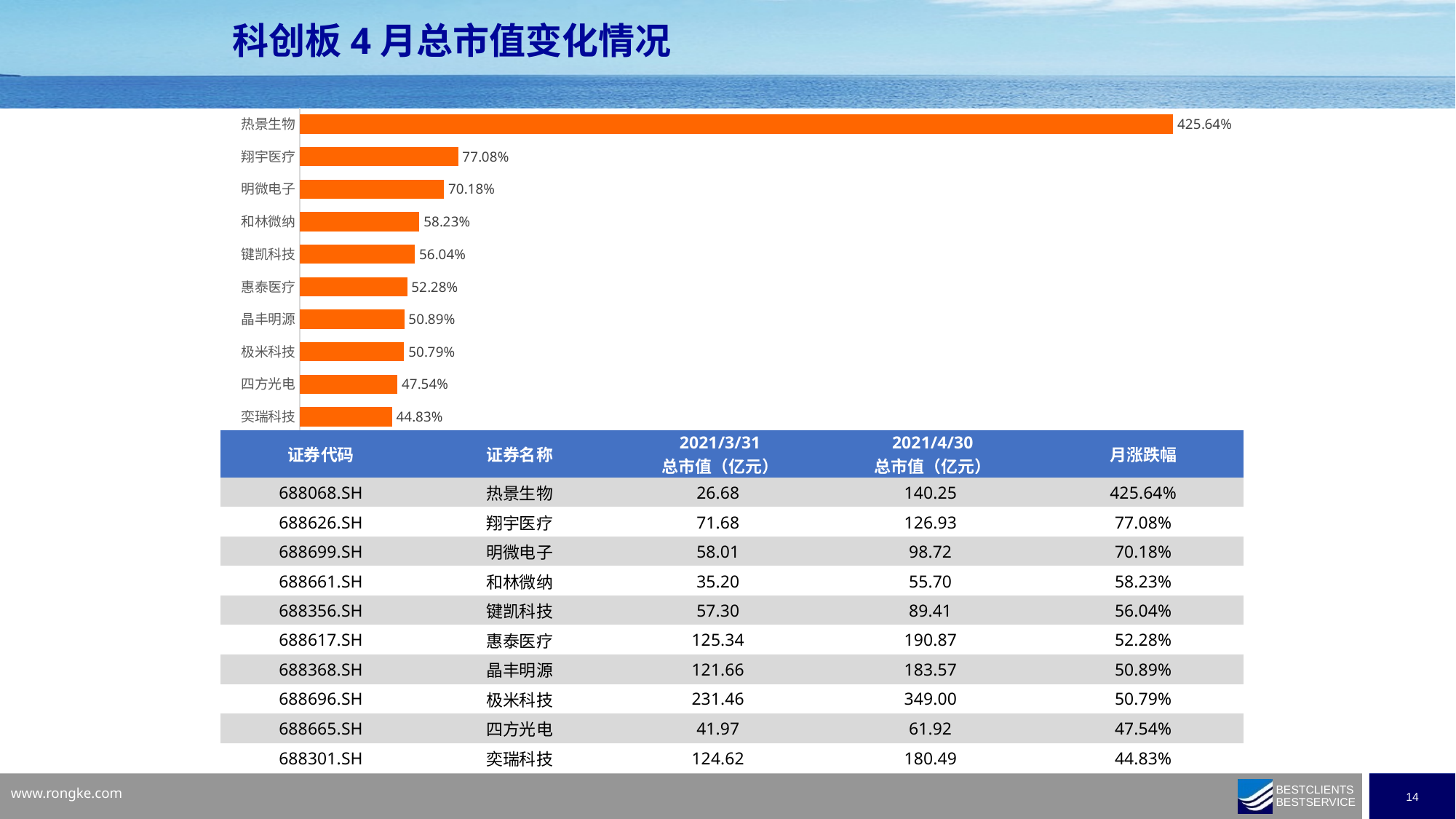
What is the difference between the values for 热景生物 and 翔宇医疗 in the bar chart? 348.56% What is the value shown for 热景生物 in the bar chart? 425.64% Which category has the lowest value in the bar chart? 奕瑞科技 What is the difference between the values for 翔宇医疗 and 明微电子 in the bar chart? 6.90% Which has a larger value in the bar chart, 惠泰医疗 or 四方光电? 惠泰医疗 What colour are the bars in the chart? orange What is the value shown for 奕瑞科技 in the bar chart? 44.83% What is the value shown for 键凯科技 in the bar chart? 56.04% How many categories are shown in the bar chart? 10 Which category has the highest value in the bar chart? 热景生物 What kind of chart is shown on the slide? bar chart What is the value shown for 和林微纳 in the bar chart? 58.23%